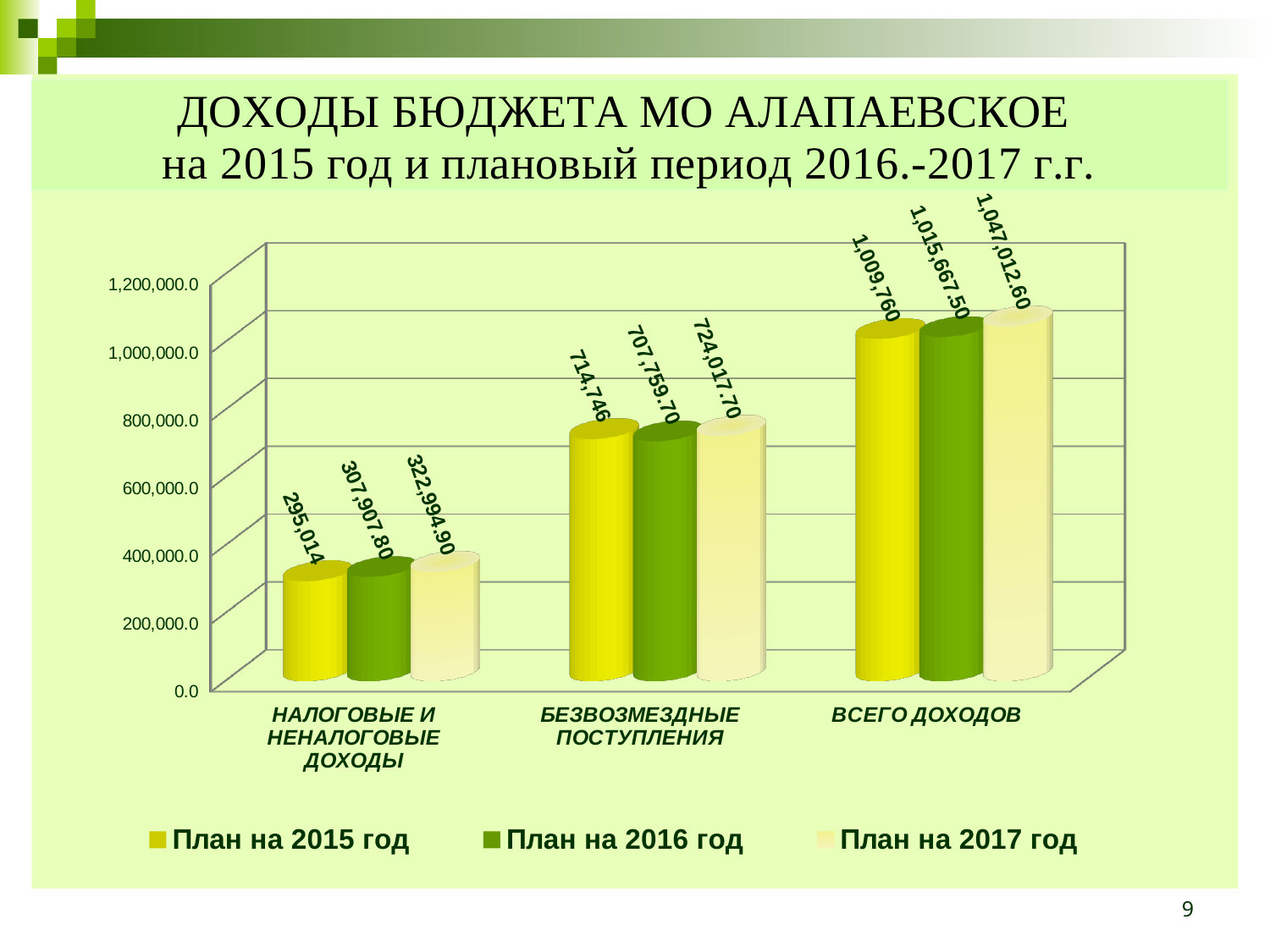
How many series does the legend list? 3 How many categories are shown on the x axis? 3 What kind of chart is shown on the slide? bar chart What is the difference between the План на 2017 год and План на 2015 год values for ВСЕГО ДОХОДОВ? 37,252.60 For БЕЗВОЗМЕЗДНЫЕ ПОСТУПЛЕНИЯ, which is larger: the План на 2015 год value or the План на 2016 год value? План на 2015 год What is the value for БЕЗВОЗМЕЗДНЫЕ ПОСТУПЛЕНИЯ in the series План на 2017 год? 724,017.70 What is the value for ВСЕГО ДОХОДОВ in the series План на 2016 год? 1,015,667.50 Is the value for ВСЕГО ДОХОДОВ in the series План на 2015 год greater or less than 1,000,000.0? greater What is the value for НАЛОГОВЫЕ И НЕНАЛОГОВЫЕ ДОХОДЫ in the series План на 2015 год? 295,014 Which category has the lowest value in the series План на 2015 год? НАЛОГОВЫЕ И НЕНАЛОГОВЫЕ ДОХОДЫ What is the difference between the План на 2017 год and План на 2015 год values for НАЛОГОВЫЕ И НЕНАЛОГОВЫЕ ДОХОДЫ? 27,980.90 Which category has the highest value in the series План на 2017 год? ВСЕГО ДОХОДОВ